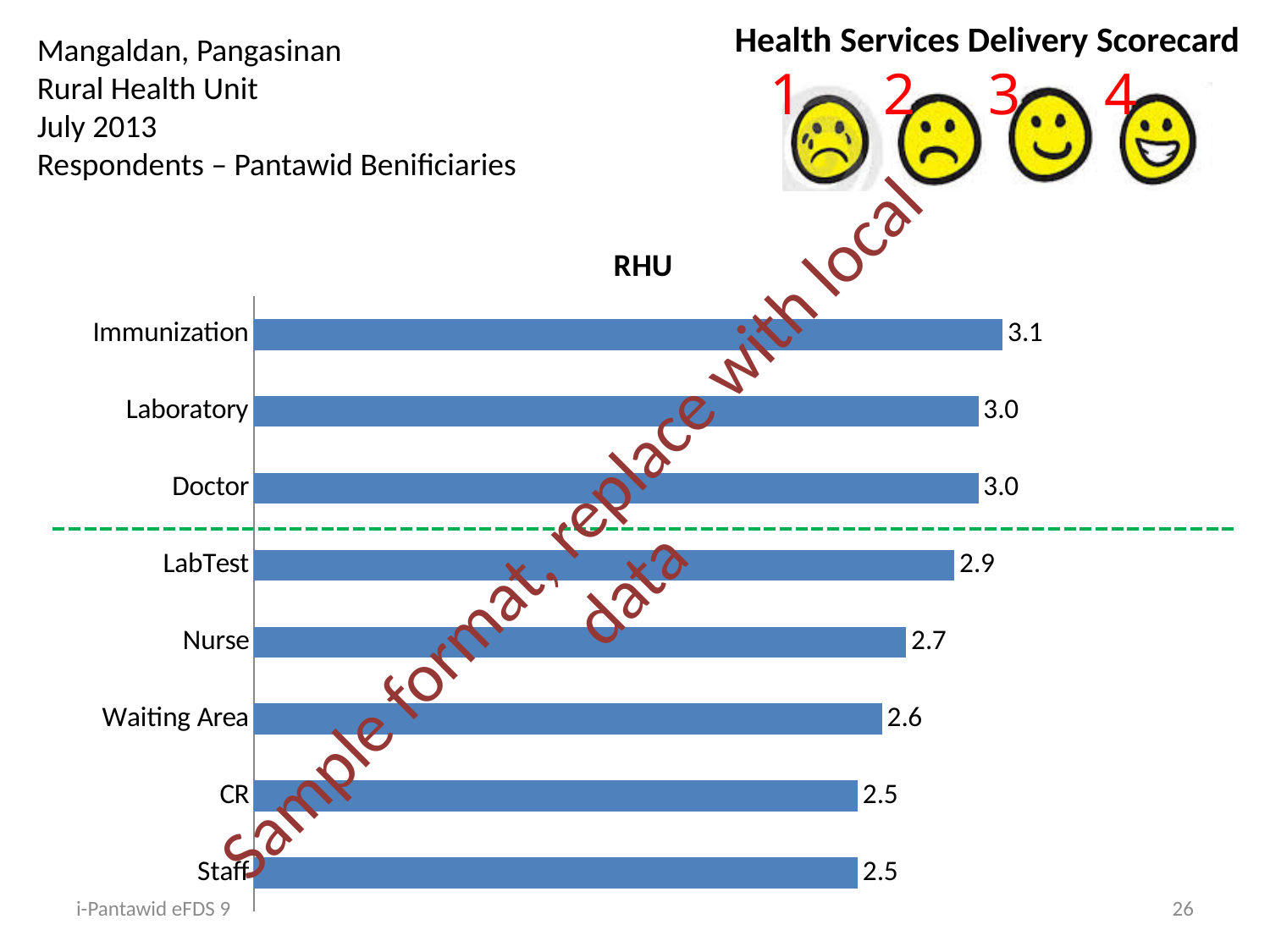
What kind of chart is the RHU chart? bar chart What is the value for Immunization in the RHU chart? 3.1 What is the value for LabTest in the RHU chart? 2.9 What is the difference between the values for LabTest and Nurse in the RHU chart? 0.2 Which is larger in the RHU chart, the value for Doctor or the value for Waiting Area? Doctor What is the title of the chart on the slide? RHU What is the value for Waiting Area in the RHU chart? 2.6 What is the difference between the values for Immunization and Staff in the RHU chart? 0.6 What colour are the bars in the RHU chart? blue What is the value for Nurse in the RHU chart? 2.7 How many categories are shown in the RHU chart? 8 Which category has the highest value in the RHU chart? Immunization